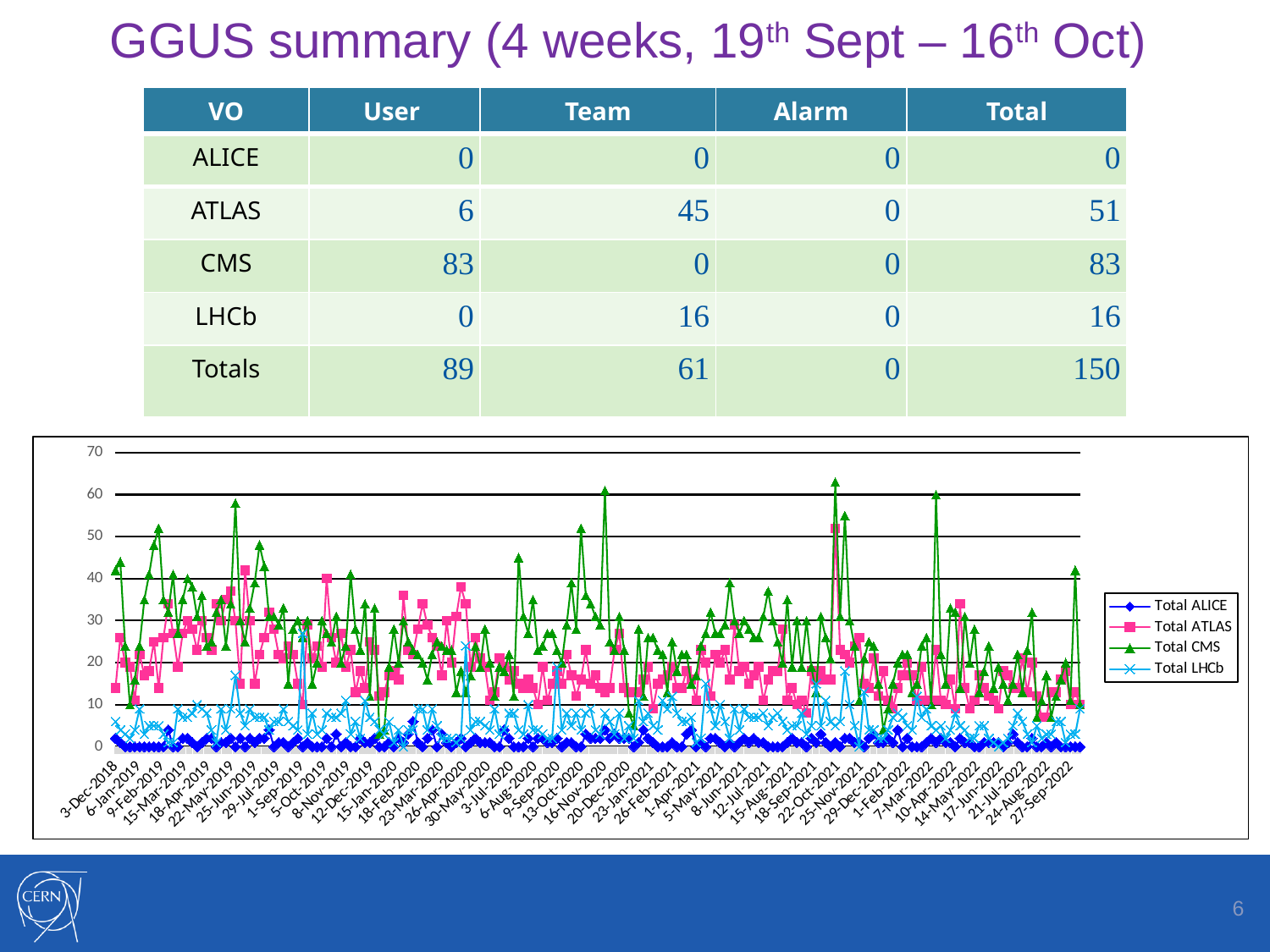
Which series reaches the highest value anywhere on the chart? Total CMS What kind of chart is shown on the slide? line chart Which series is generally higher across the chart, Total CMS or Total LHCb? Total CMS How many series does the chart's legend list? 4 What is the first date label on the chart's horizontal axis? 3-Dec-2018 Is the highest value of the Total ALICE series greater or less than 10? less Is the highest peak of the Total ATLAS series greater or less than 40? greater Is the highest peak of the Total CMS series greater or less than 50? greater Which series stays lowest across the chart, close to zero throughout? Total ALICE Which series are listed in the chart's legend? Total ALICE, Total ATLAS, Total CMS, Total LHCb What is the last date label on the chart's horizontal axis? 27-Sep-2022 What is the highest value shown on the chart's vertical axis? 70